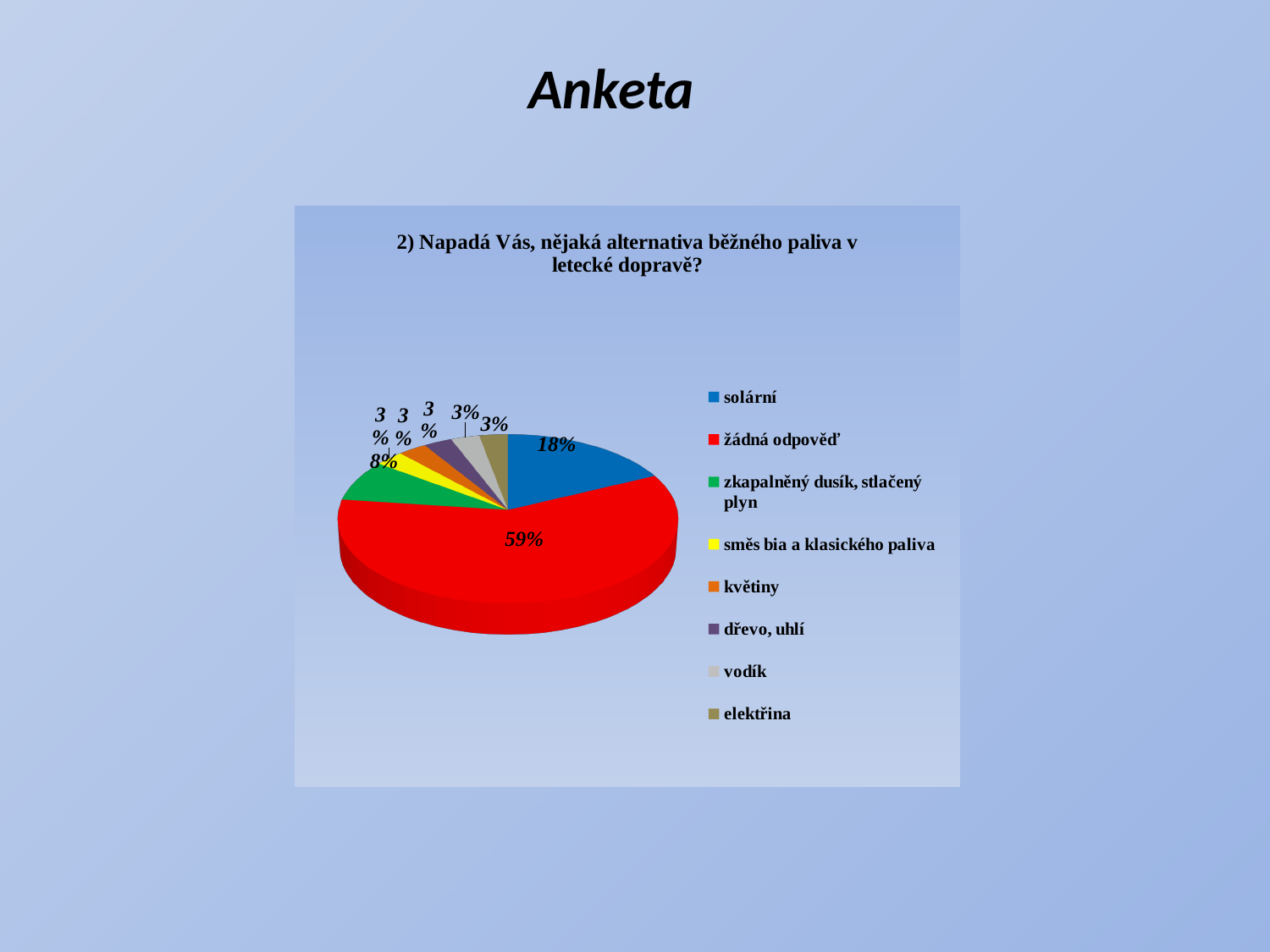
What is the title of the chart? 2) Napadá Vás, nějaká alternativa běžného paliva v letecké dopravě? Which slice is larger, "solární" or "zkapalněný dusík, stlačený plyn"? solární What kind of chart is shown on the slide? pie chart How many categories are listed in the legend of the pie chart? 8 Which category has the largest slice of the pie chart? žádná odpověď What colour is the "žádná odpověď" slice in the pie chart? red What percentage of the pie chart is labelled for "žádná odpověď"? 59% What is the difference in percentage points between the "solární" slice and the "zkapalněný dusík, stlačený plyn" slice? 10 What is the difference in percentage points between the "žádná odpověď" slice and the "solární" slice? 41 What percentage of the pie chart is labelled for "solární"? 18% What percentage of the pie chart is labelled for "zkapalněný dusík, stlačený plyn"? 8% What share of the pie does the "žádná odpověď" slice represent? 59%